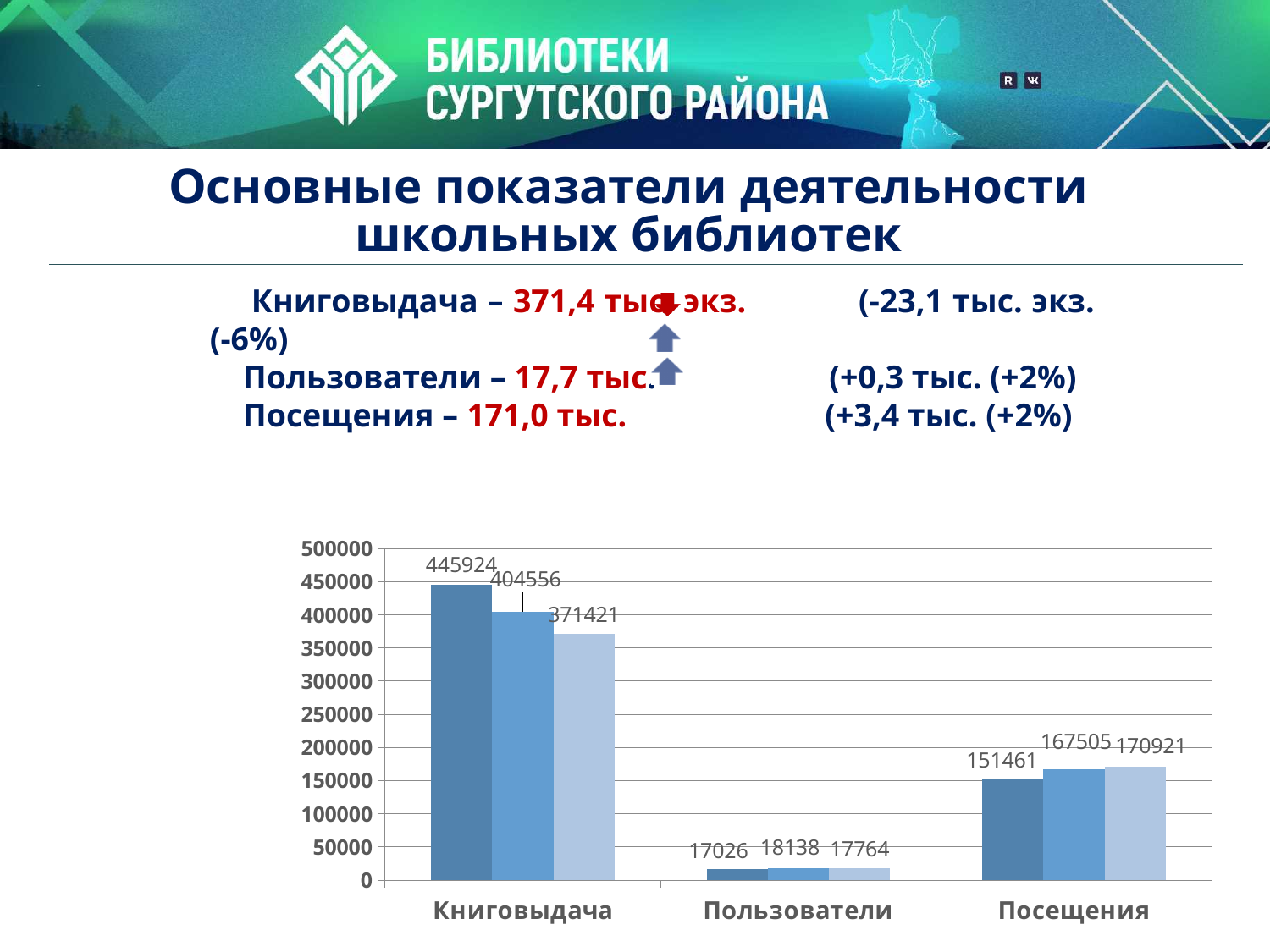
What kind of chart is shown on the slide? bar chart Which is larger: the first bar for Посещения or the third bar for Посещения? the third bar (170921) Which category has the lowest bars in the chart? Пользователи How many bars are plotted for each category in the chart? 3 What is the value of the third (light blue) bar for Книговыдача? 371421 What is the value of the second (medium blue) bar for Пользователи? 18138 Which category has the highest bars in the chart? Книговыдача What is the value of the first (dark blue) bar for Книговыдача? 445924 What is the difference between the first and third bars for Книговыдача (445924 and 371421)? 74503 What is the value of the third (light blue) bar for Посещения? 170921 How many categories are shown on the x axis of the chart? 3 Do the three bars for Книговыдача rise or fall from left to right? fall